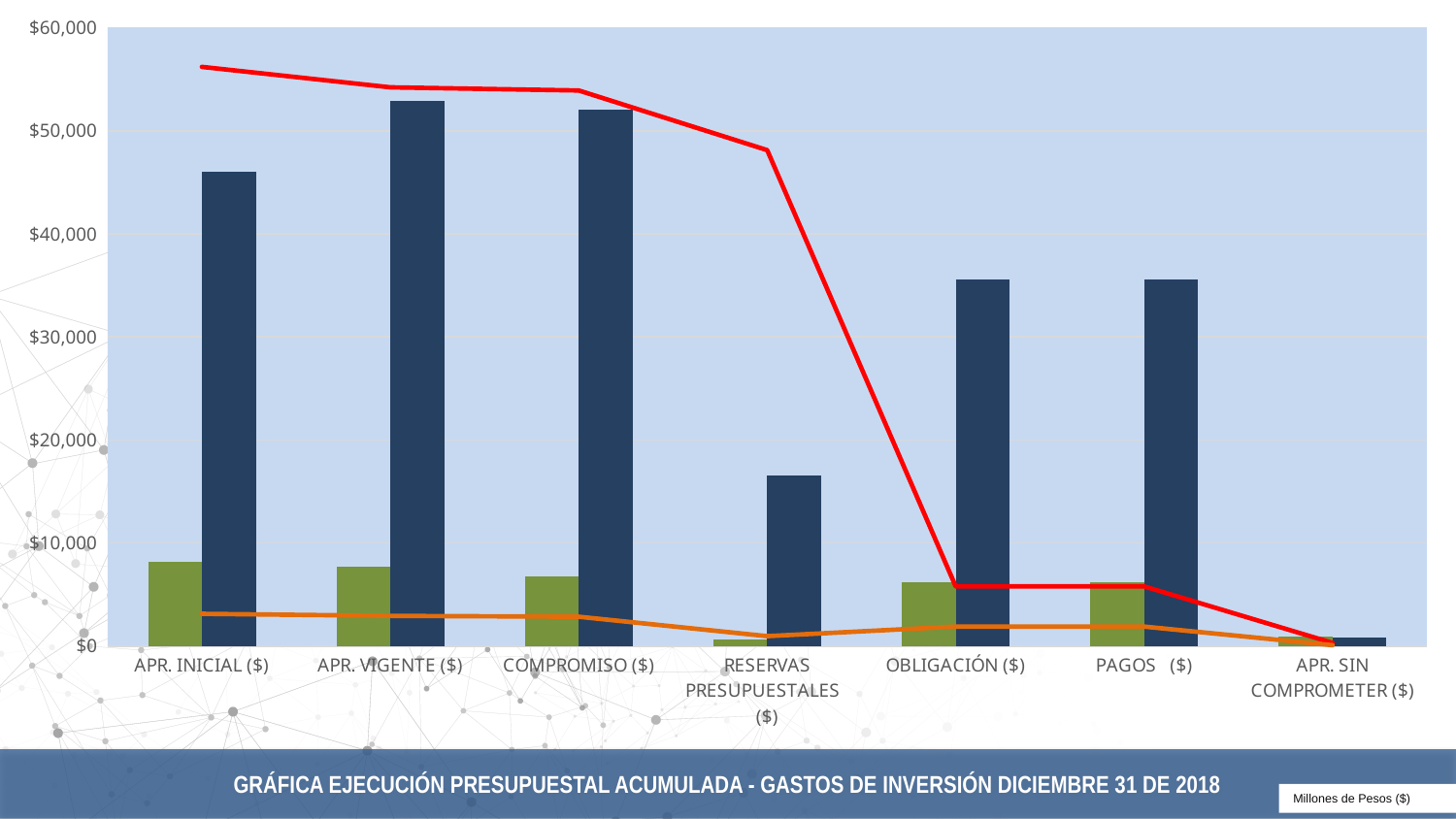
Is the dark blue bar for OBLIGACIÓN ($) greater or less than $40,000? less How many categories are shown on the x axis of the chart? 7 Does the red line rise or fall from left to right across the categories? It falls Which category has the lowest dark blue bar? APR. SIN COMPROMETER ($) In what units are the values on the chart expressed, according to the note on the slide? Millones de Pesos ($) Is the dark blue bar for RESERVAS PRESUPUESTALES ($) greater or less than $20,000? less What kind of chart is shown on the slide? A bar chart combined with line series What is the title of the chart? GRÁFICA EJECUCIÓN PRESUPUESTAL ACUMULADA - GASTOS DE INVERSIÓN DICIEMBRE 31 DE 2018 Which dark blue bar is taller, APR. INICIAL ($) or OBLIGACIÓN ($)? APR. INICIAL ($) Is the dark blue bar for APR. VIGENTE ($) greater or less than $50,000? greater